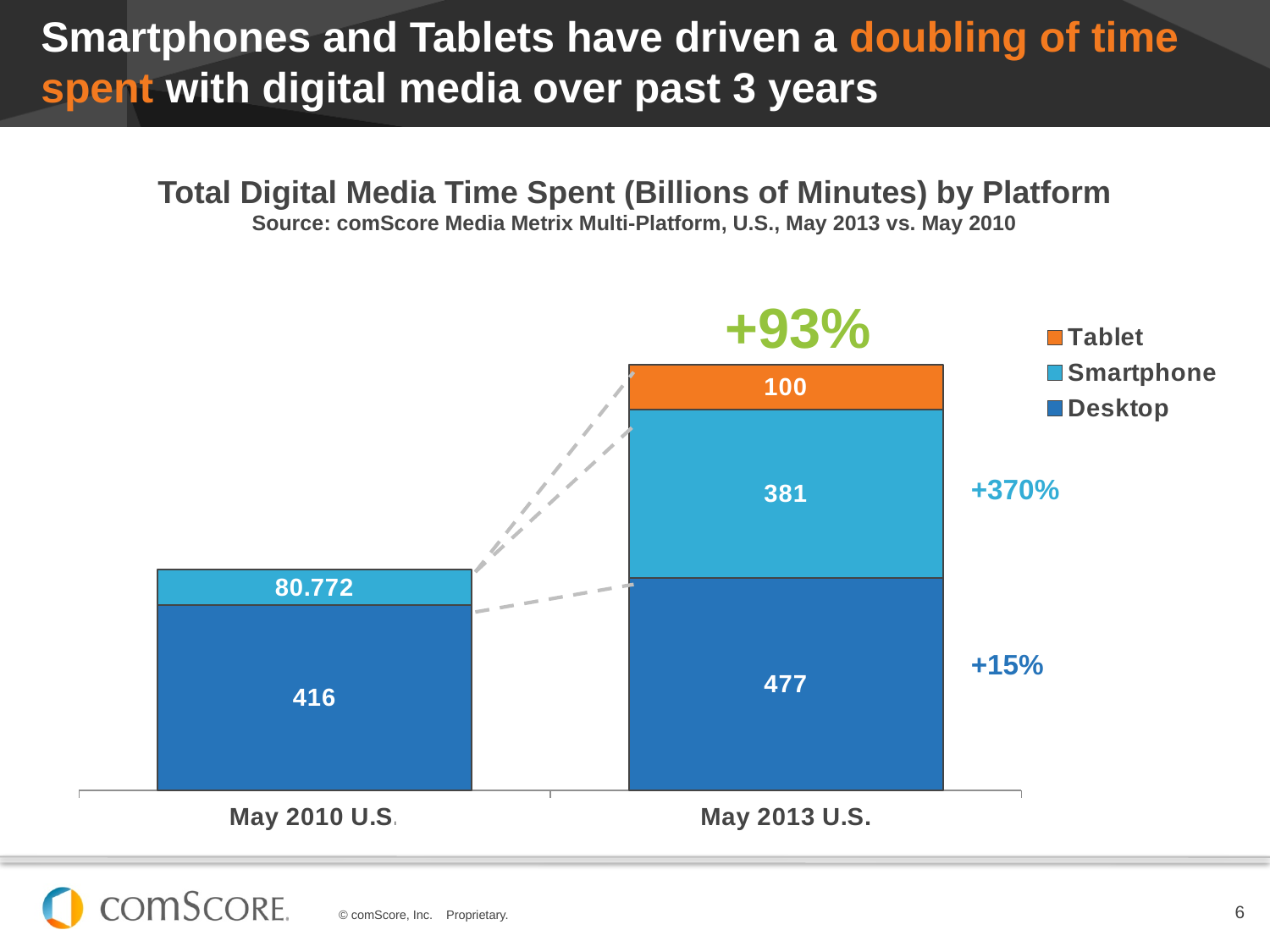
Which is larger for May 2013 U.S., the Smartphone value or the Tablet value? Smartphone What is the Desktop value for May 2013 U.S.? 477 What is the Desktop value for May 2010 U.S.? 416 How many categories are shown on the x axis? 2 What is the Smartphone value for May 2010 U.S.? 80.772 What is the difference between the Desktop values for May 2013 U.S. and May 2010 U.S.? 61 What is the Tablet value for May 2013 U.S.? 100 What is the difference between the Smartphone value and the Tablet value for May 2013 U.S.? 281 How many series does the legend list? 3 What percentage growth is shown above the May 2013 U.S. bar? +93% What is the total of the stacked bar for May 2013 U.S.? 958 What kind of chart is shown on the slide? Stacked bar chart